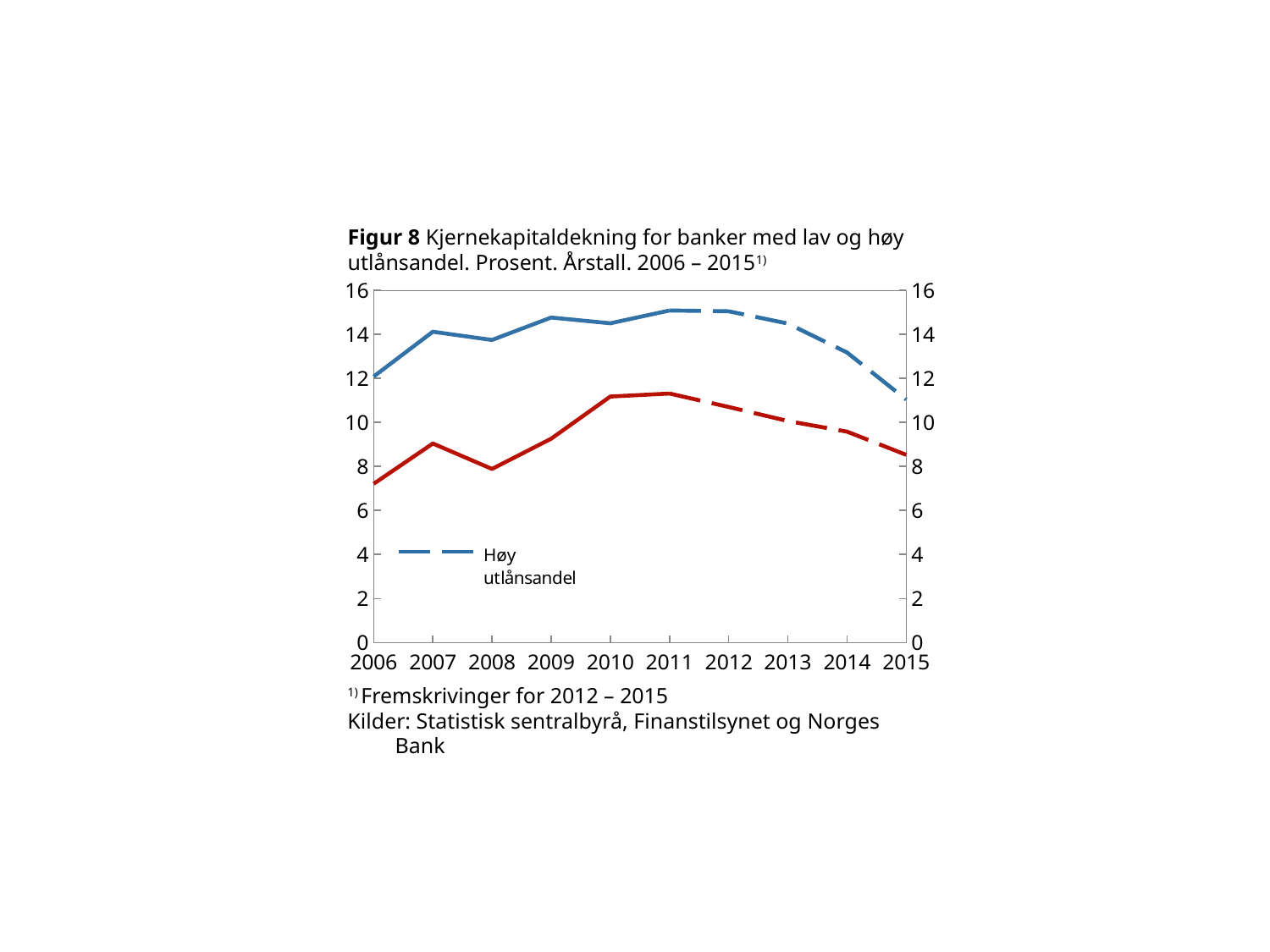
According to the footnote, which years are projections (fremskrivinger)? 2012 – 2015 How many years are shown on the x axis of the chart? 10 How many series does the legend of the chart list? 1 Is the value for Høy utlånsandel in 2015 greater or less than 12? less What kind of chart is shown on the slide? line chart Is the value for Høy utlånsandel in 2014 greater or less than 14? less In which year is the value for Høy utlånsandel lowest? 2015 Is the value for Høy utlånsandel in 2008 greater or less than 12? greater Which is larger for Høy utlånsandel, the value in 2009 or the value in 2014? 2009 Does the value for Høy utlånsandel rise or fall from 2012 to 2015? fall